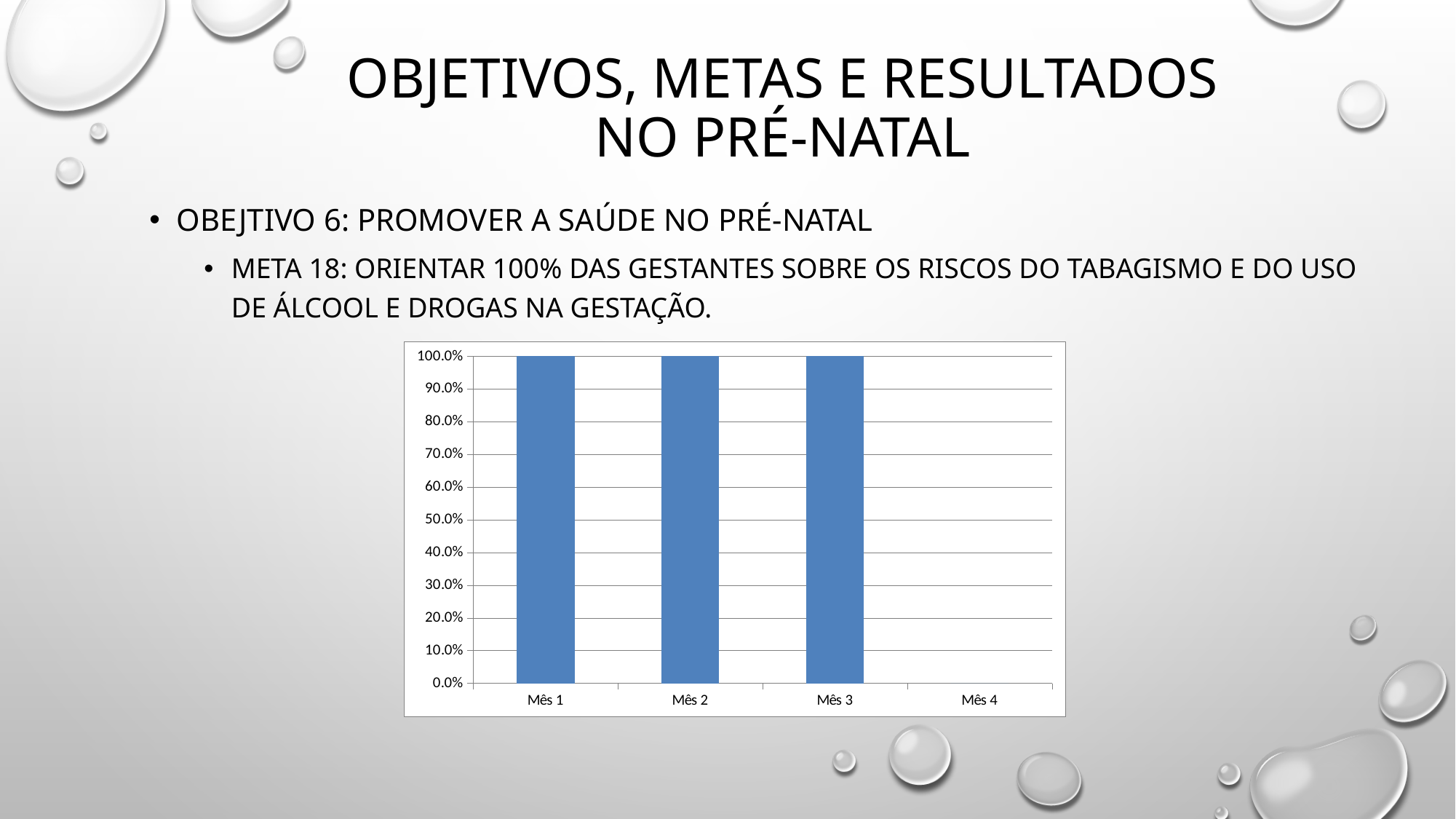
What is the value for Mês 1? 100.0% What is the value for Mês 3? 100.0% What is the difference between the values for Mês 1 and Mês 2? 0.0% How many categories are shown on the x axis? 4 What colour are the bars in the chart? blue Which category has the lowest value? Mês 4 Do the values rise or fall from Mês 3 to Mês 4? fall What is the highest value shown on the y axis? 100.0% Which is larger, the value for Mês 2 or the value for Mês 4? Mês 2 Is the value for Mês 4 greater or less than 10.0%? less Is the value for Mês 2 greater or less than 90.0%? greater What kind of chart is shown on the slide? bar chart